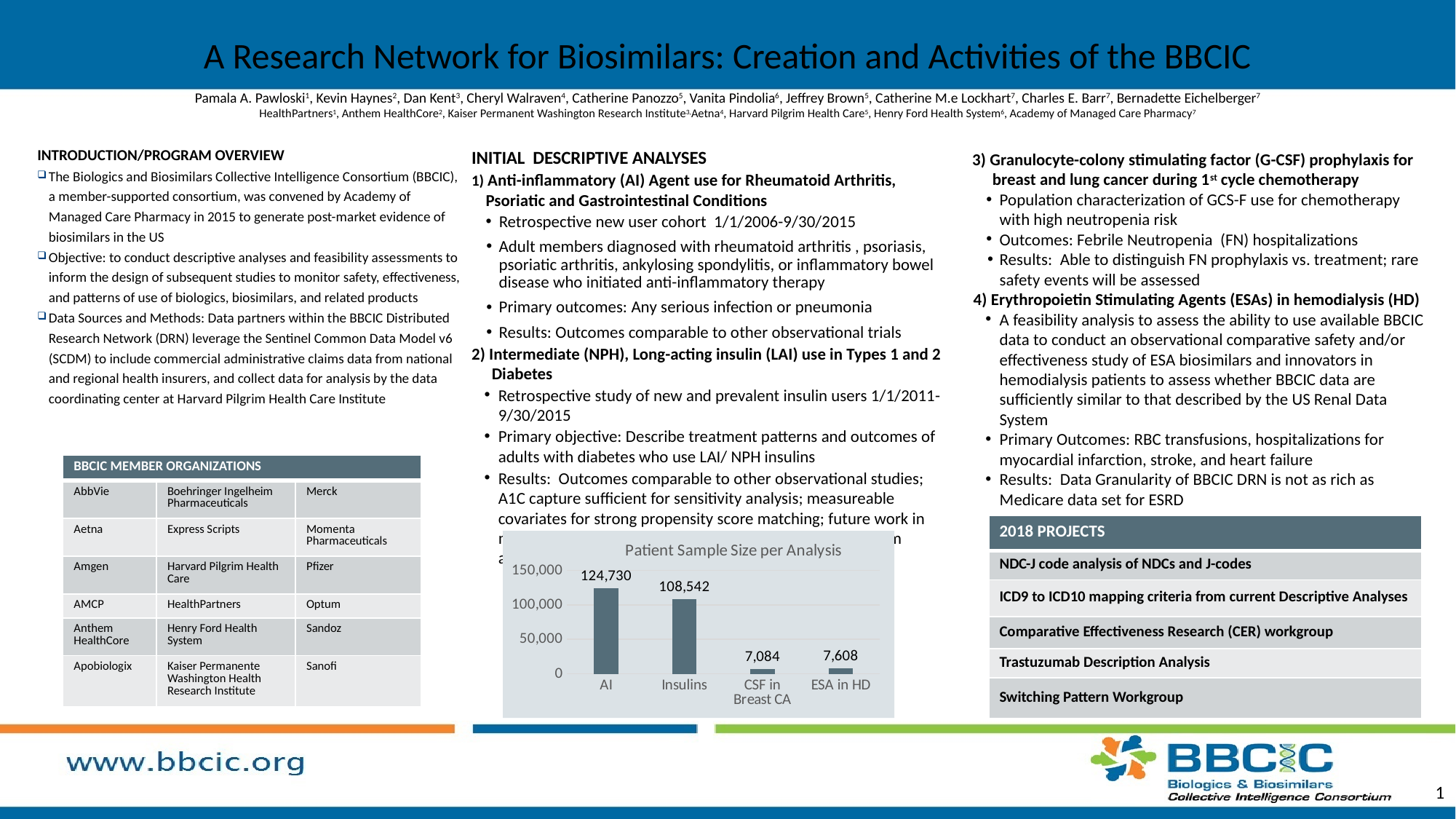
What is the patient sample size for AI in the chart? 124,730 What is the patient sample size for CSF in Breast CA in the chart? 7,084 Which analysis has the largest patient sample size in the chart? AI What type of chart is used to show patient sample size per analysis? Bar chart Which has a larger patient sample size, AI or Insulins? AI What is the patient sample size for ESA in HD in the chart? 7,608 What is the difference in patient sample size between ESA in HD and CSF in Breast CA? 524 How many analyses are shown in the chart? 4 Is the patient sample size for Insulins greater or less than 100,000? greater What is the patient sample size for Insulins in the chart? 108,542 Which analysis has the smallest patient sample size in the chart? CSF in Breast CA What is the difference in patient sample size between AI and Insulins? 16,188